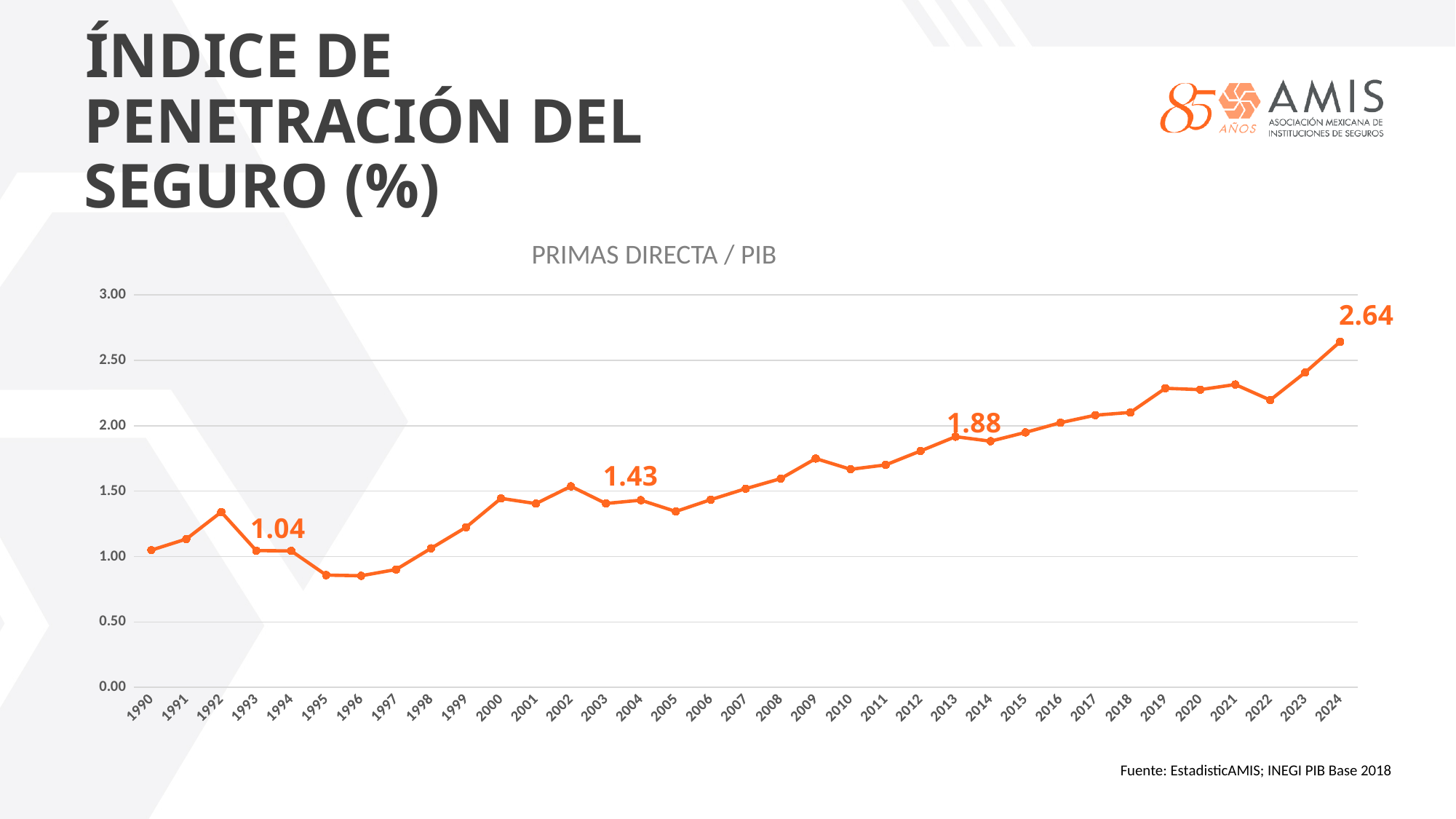
What is the highest value shown on the y axis? 3.00 Is the value for 2022 greater or less than 2.50? less What is the value for 2024? 2.64 What is the difference between the labeled values 2.64 and 1.04? 1.60 Is the value for 1990 greater or less than 1.50? less Which is larger, the value for 2002 or the value for 2005? 2002 Is the value for 2019 greater or less than 2.00? greater How many years (data points) are plotted on the x axis? 35 What is the subtitle shown above the chart? PRIMAS DIRECTA / PIB Which year has the highest value? 2024 Overall, do the values rise or fall from 1990 to 2024? rise What kind of chart is shown on the slide? line chart